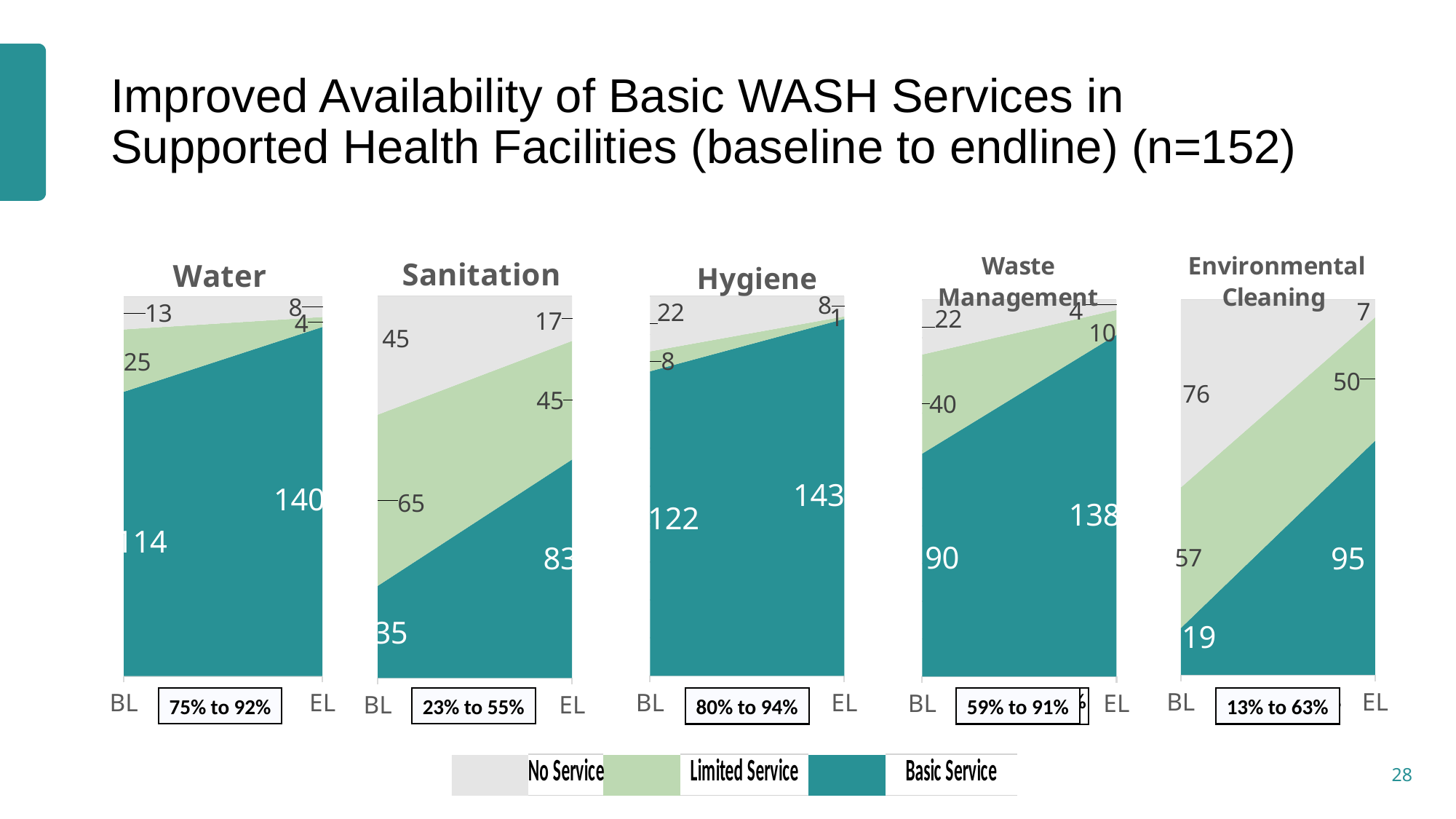
In the Environmental Cleaning chart, what is the difference between the No Service values at BL and EL? 69 In the Hygiene chart, what is the No Service value at BL? 22 How many series does the legend list? 3 In the Waste Management chart, what is the total of the three series at EL? 152 In the Water chart, does the Basic Service value rise or fall from BL to EL? rise In the Hygiene chart, which is larger: the Basic Service value at BL or at EL? EL In the Environmental Cleaning chart, what is the Basic Service value at EL? 95 What percentage change is shown in the box below the Sanitation chart? 23% to 55% In the Water chart, what is the Basic Service value at EL? 140 In the Sanitation chart, what is the Limited Service value at BL? 65 What kind of chart is used for each of the five panels? stacked area chart In the Waste Management chart, by how much did the Basic Service value increase from BL to EL? 48